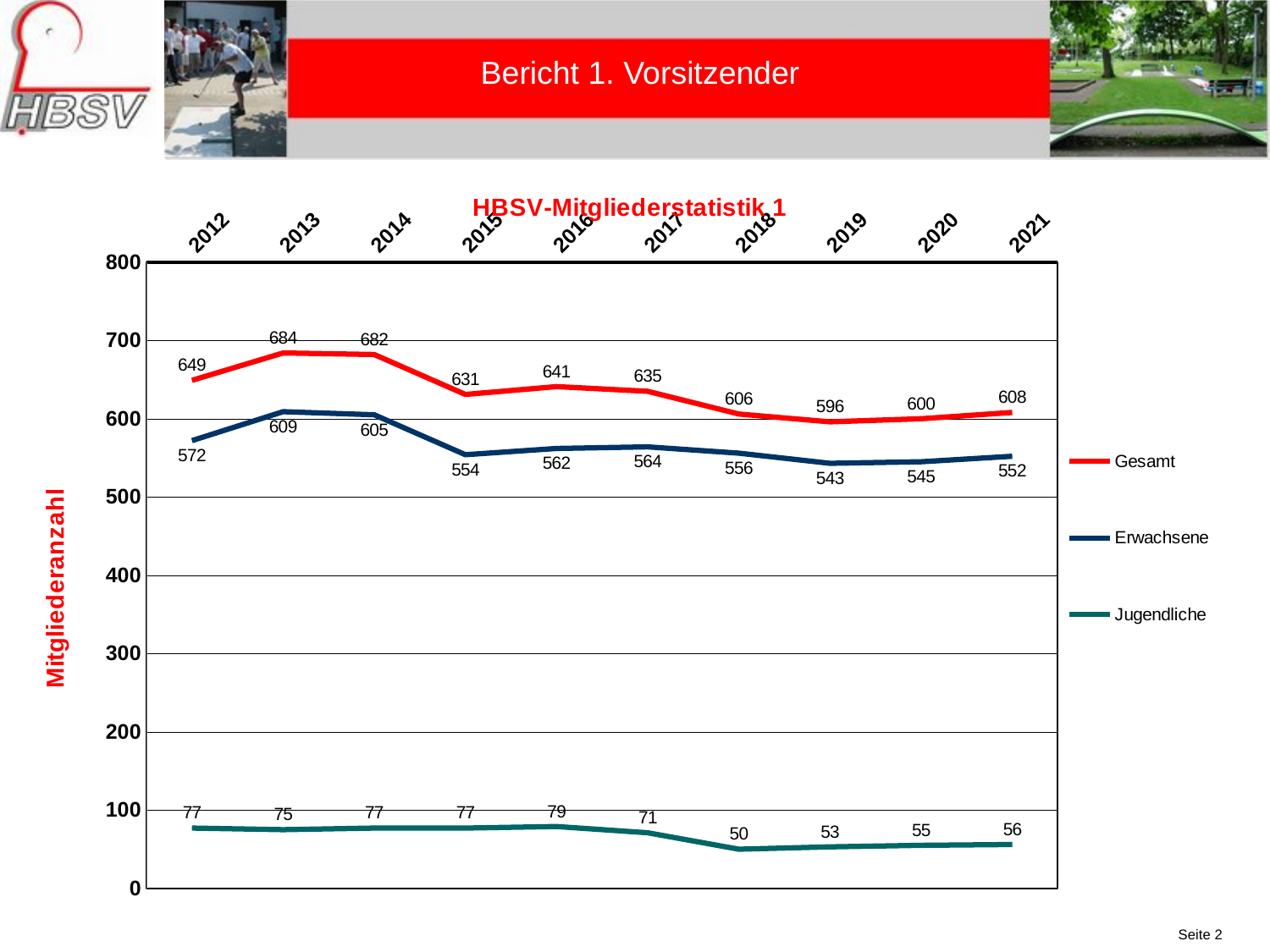
Which is larger: Erwachsene in 2016 or Erwachsene in 2017? Erwachsene in 2017 What kind of chart is this? line chart What is the title of the chart? HBSV-Mitgliederstatistik 1 How many years are shown on the x axis? 10 What is the value of Erwachsene in 2019? 543 What is the difference between Gesamt in 2012 and Gesamt in 2021? 41 In which year is Gesamt highest? 2013 What is the value of Gesamt in 2013? 684 What is the value of Jugendliche in 2018? 50 In which year is Jugendliche lowest? 2018 Is the value of Gesamt in 2019 greater or less than 600? less How many series does the legend list? 3